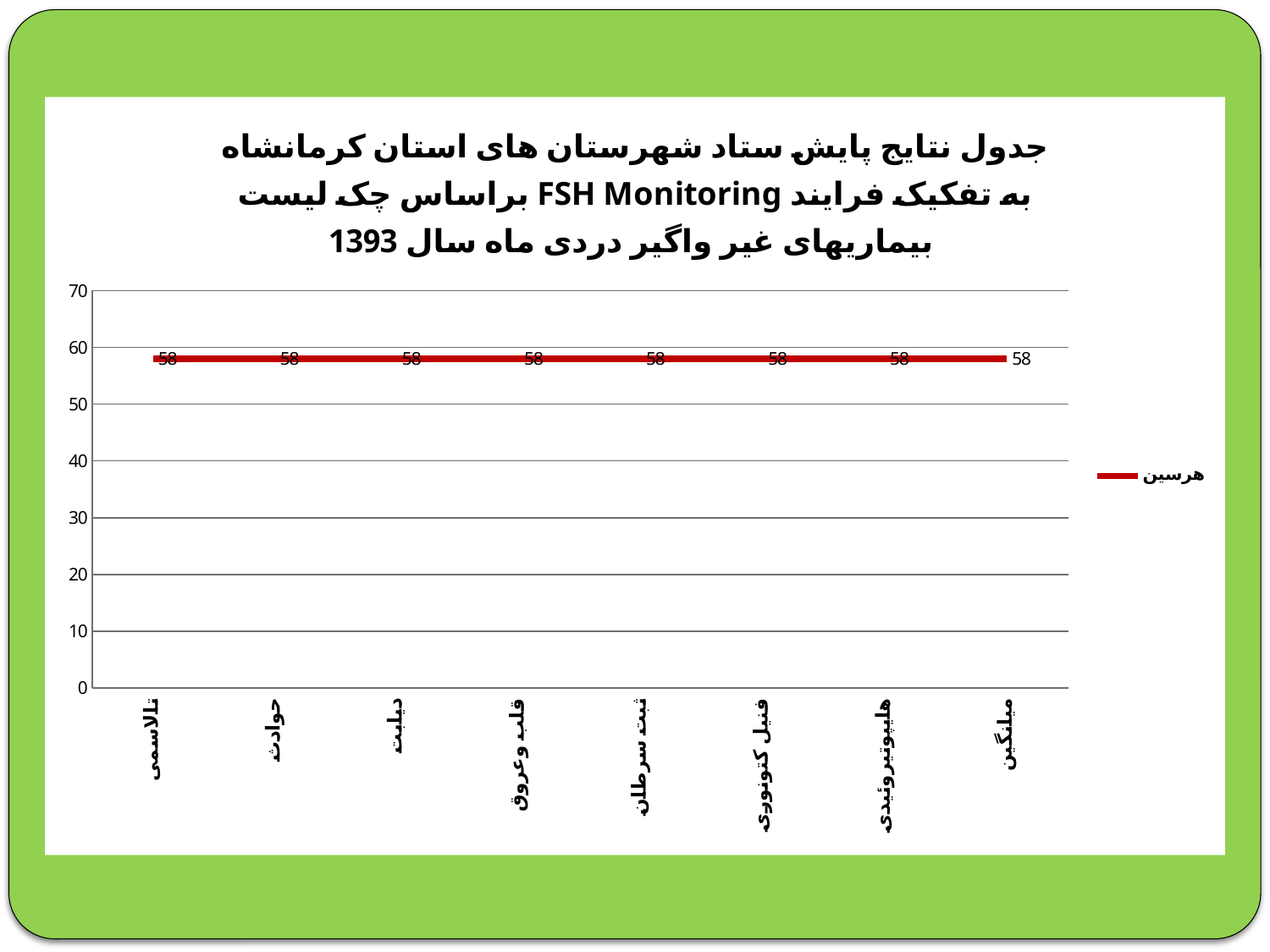
What is the value for دیابت? 58 What type of chart is shown on the slide? line chart What is the value for هیپوتیروئیدی? 58 What is the name of the series shown in the legend? هرسین How many categories are plotted on the x axis? 8 What is the value for میانگین? 58 What colour is the line for هرسین? dark red Do the values rise, fall, or stay flat across the categories on the x axis? stay flat What is the value for ثبت سرطان? 58 What is the difference between the values for حوادث and قلب وعروق? 0 How many series does the legend list? 1 Is the value for فنیل کتونوری greater or less than 50? greater